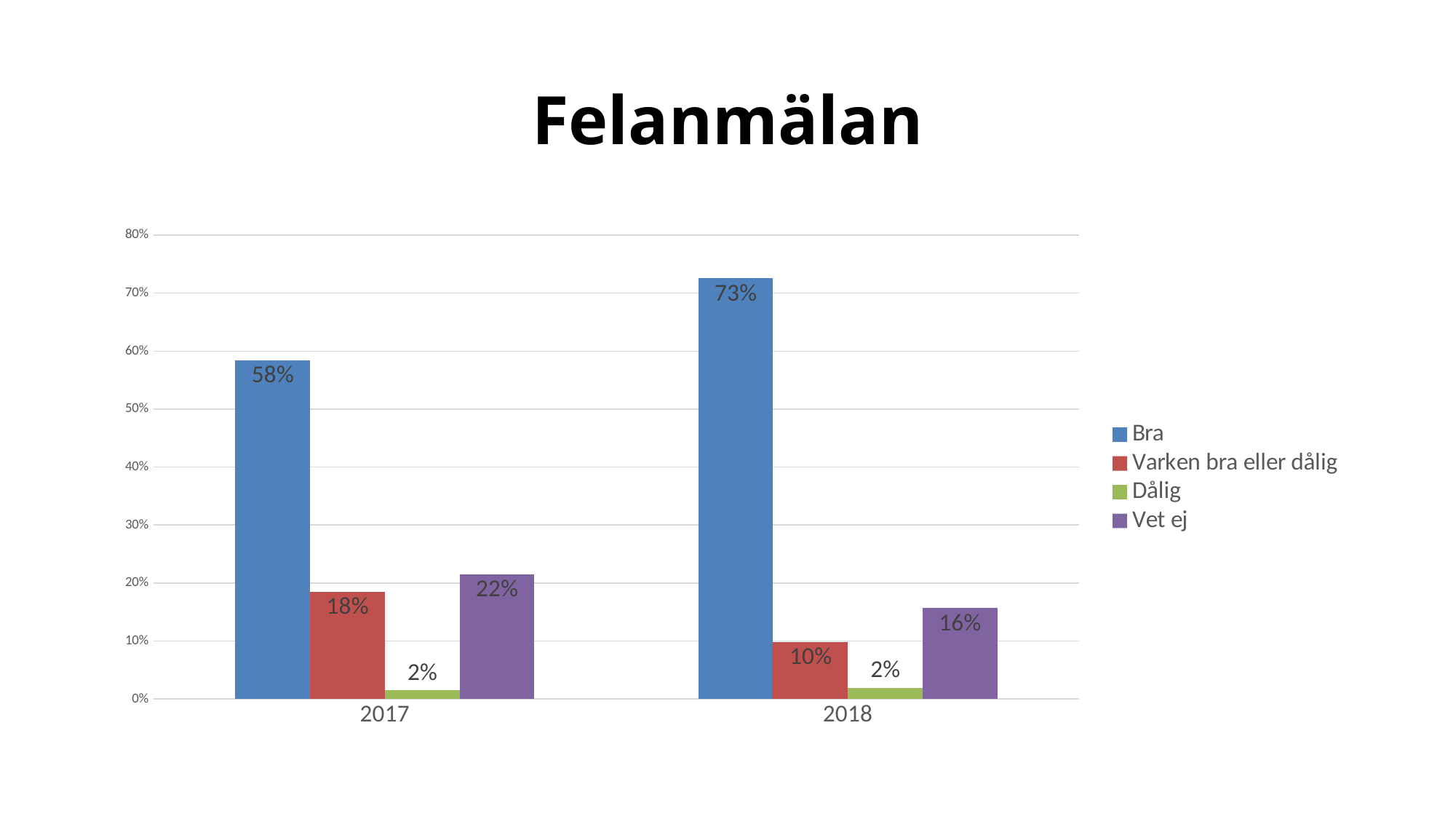
Which series has the lowest value in 2017? Dålig What is the value for Bra in 2018? 73% What is the value for Vet ej in 2017? 22% Is the value for Bra in 2018 greater or less than 70%? greater What kind of chart is shown on the slide? Bar chart What is the difference between the Bra values for 2018 and 2017? 15% Which is larger: Vet ej in 2017 or Vet ej in 2018? Vet ej in 2017 How many series does the legend list? 4 What is the value for Bra in 2017? 58% What is the value for Varken bra eller dålig in 2018? 10% Which series has the highest value in 2018? Bra What is the title of the slide? Felanmälan